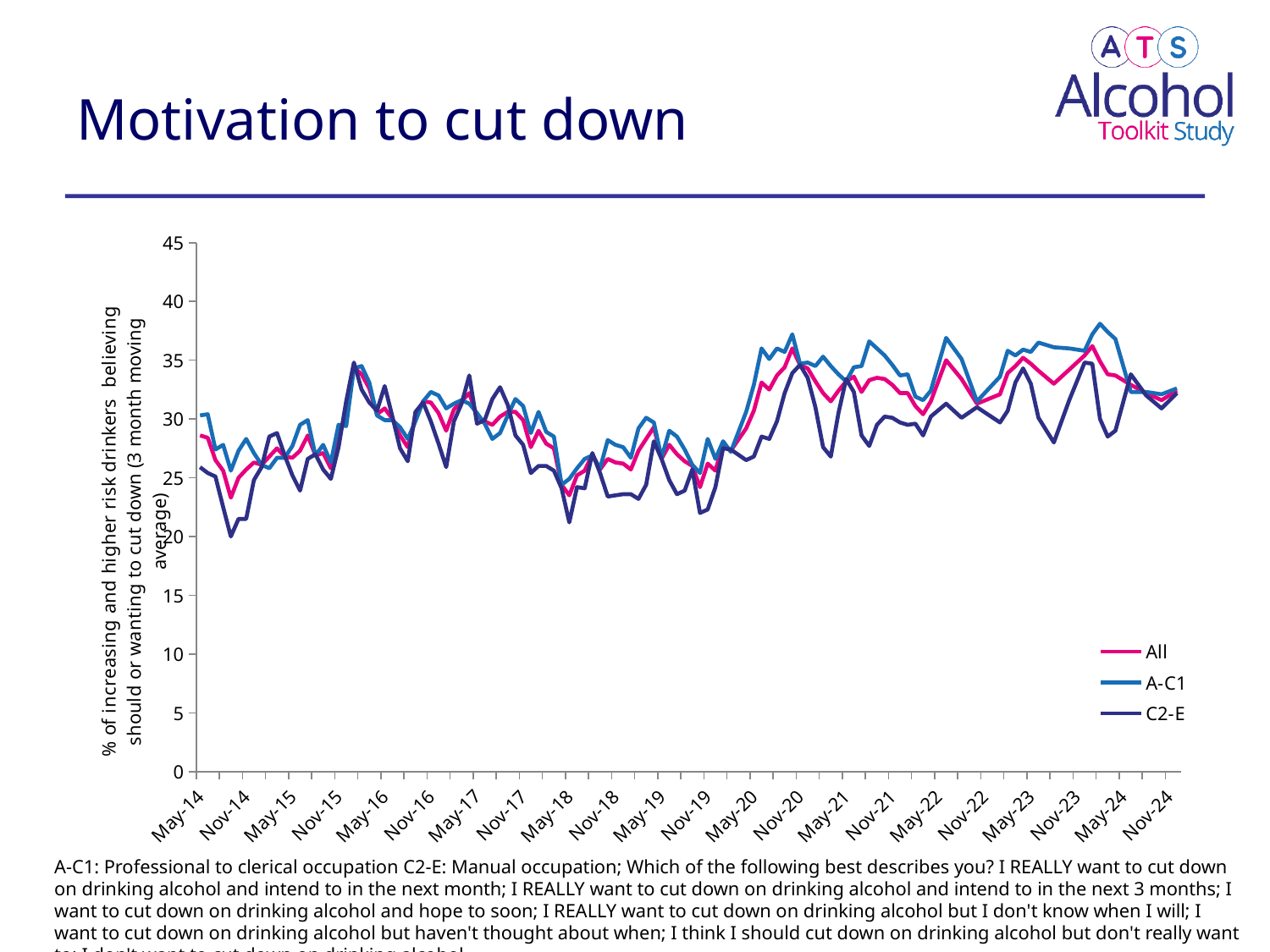
Overall, do the values for the All series rise or fall between May-14 and Nov-24? rise Is the value for A-C1 around Nov-23 greater or less than 35? greater What kind of chart is shown on the slide? Line chart Is the value for All at May-14 greater or less than 25? greater Around Nov-14, which series has the larger value, A-C1 or C2-E? A-C1 What is the highest value shown on the y axis? 45 What is the title of the slide's chart? Motivation to cut down Is the value for C2-E around Nov-14 greater or less than 25? less How many series does the legend list? 3 What are the three series named in the legend? All, A-C1, C2-E